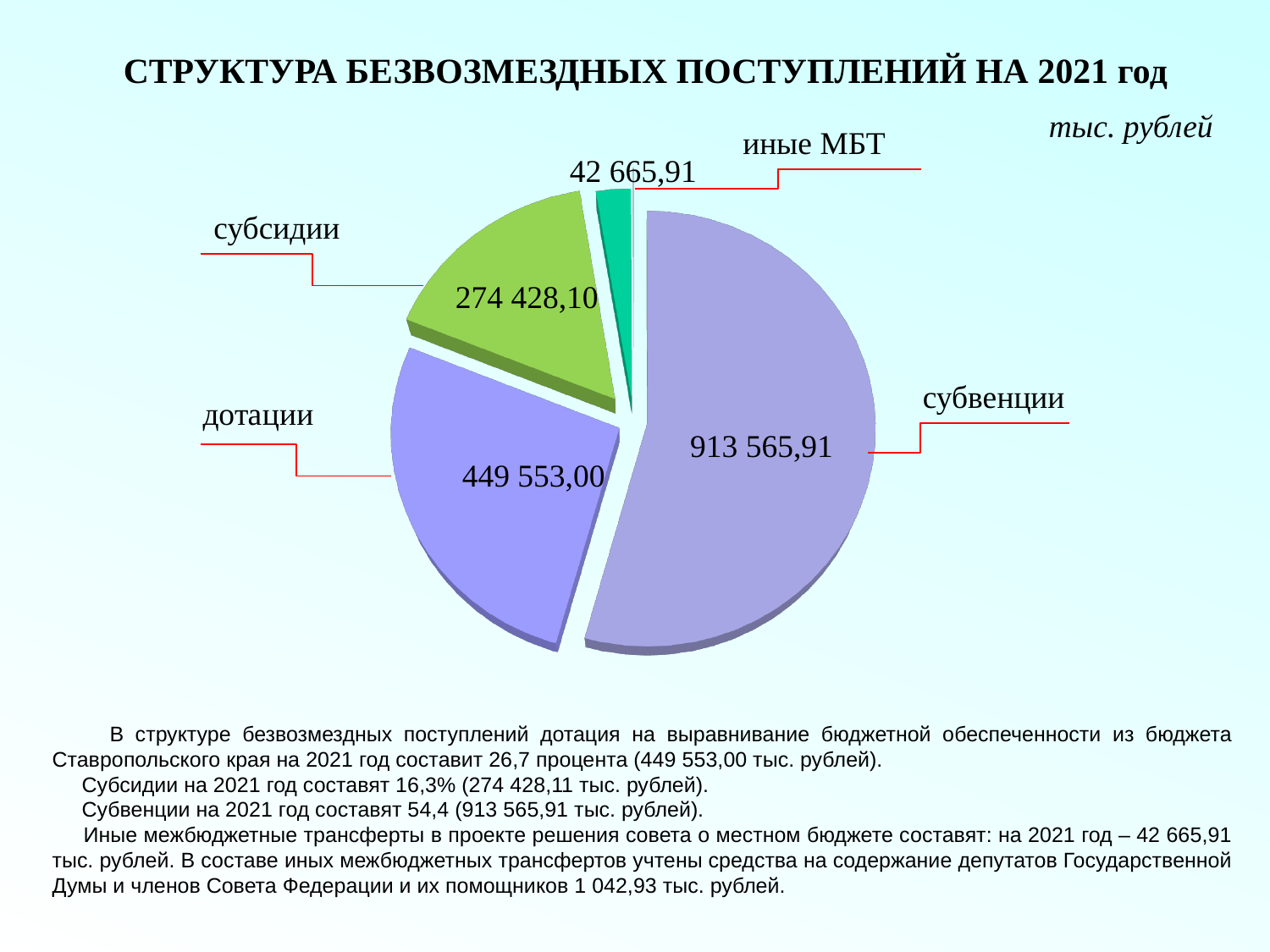
What is the value for субсидии on the pie chart? 274 428,10 What is the value for субвенции on the pie chart? 913 565,91 What is the difference between the values for дотации and субсидии? 175 124,90 Which category has the largest slice of the pie chart? субвенции What kind of chart is shown on the slide? pie chart What is the difference between the values for субвенции and дотации? 464 012,91 Which category has the smallest slice of the pie chart? иные МБТ Which is larger, the value for субсидии or the value for иные МБТ? субсидии What is the value for дотации on the pie chart? 449 553,00 How many categories are shown on the pie chart? 4 What is the value for иные МБТ on the pie chart? 42 665,91 What unit is stated for the values on the chart? тыс. рублей